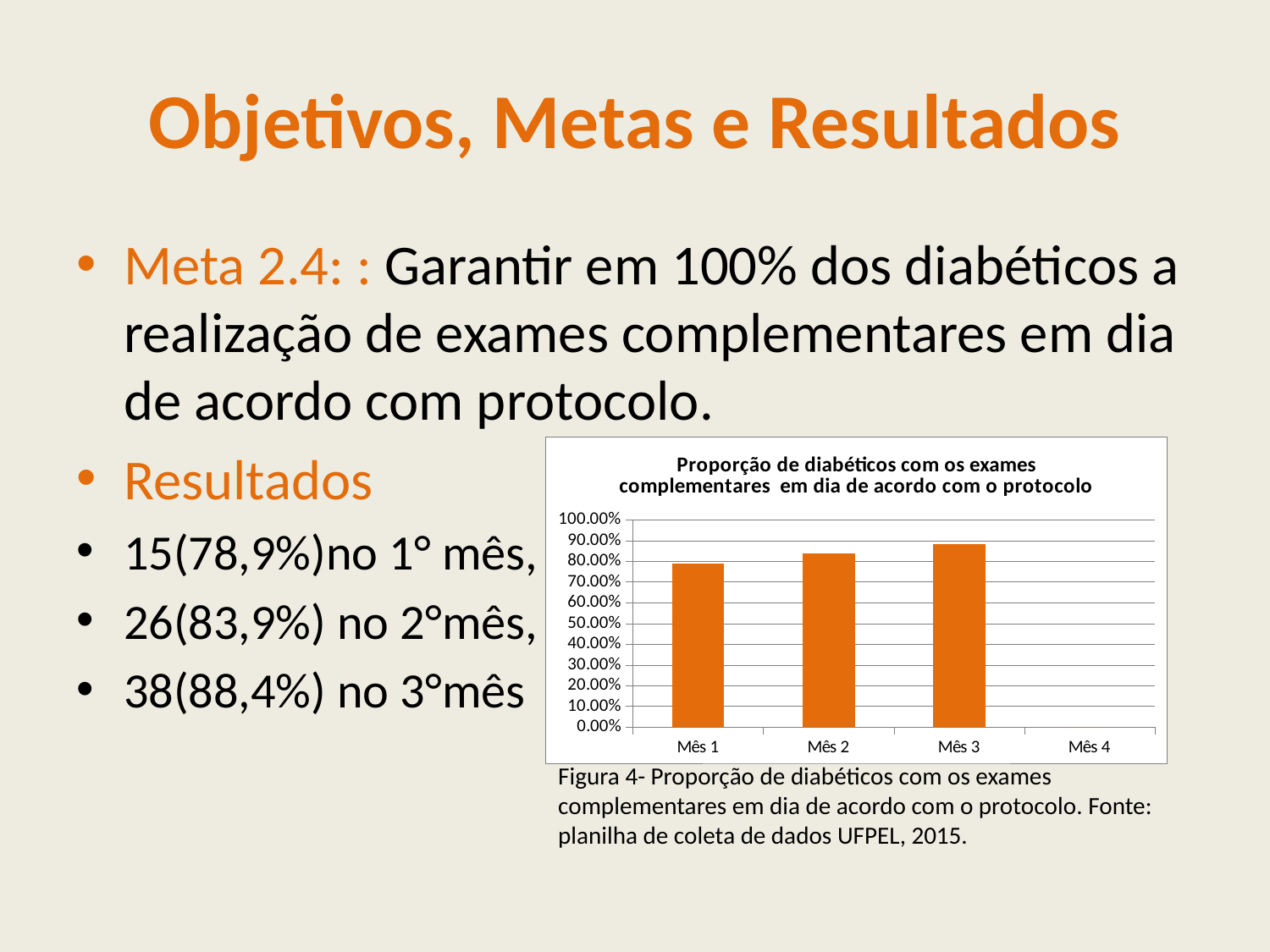
Is the value for Mês 2 greater or less than 80.00%? greater What is the title of the chart? Proporção de diabéticos com os exames complementares em dia de acordo com o protocolo What kind of chart is shown on the slide? bar chart Is the value for Mês 3 greater or less than 100.00%? less Is the value for Mês 1 greater or less than 70.00%? greater Which is larger, the value for Mês 2 or the value for Mês 3? Mês 3 Which month has the highest bar in the chart? Mês 3 How many bars are plotted in the chart? 3 Among the months with a plotted bar, which has the lowest value? Mês 1 How many categories are shown on the x axis of the chart? 4 Do the bar values rise or fall from Mês 1 to Mês 3? rise What colour are the bars in the chart? orange